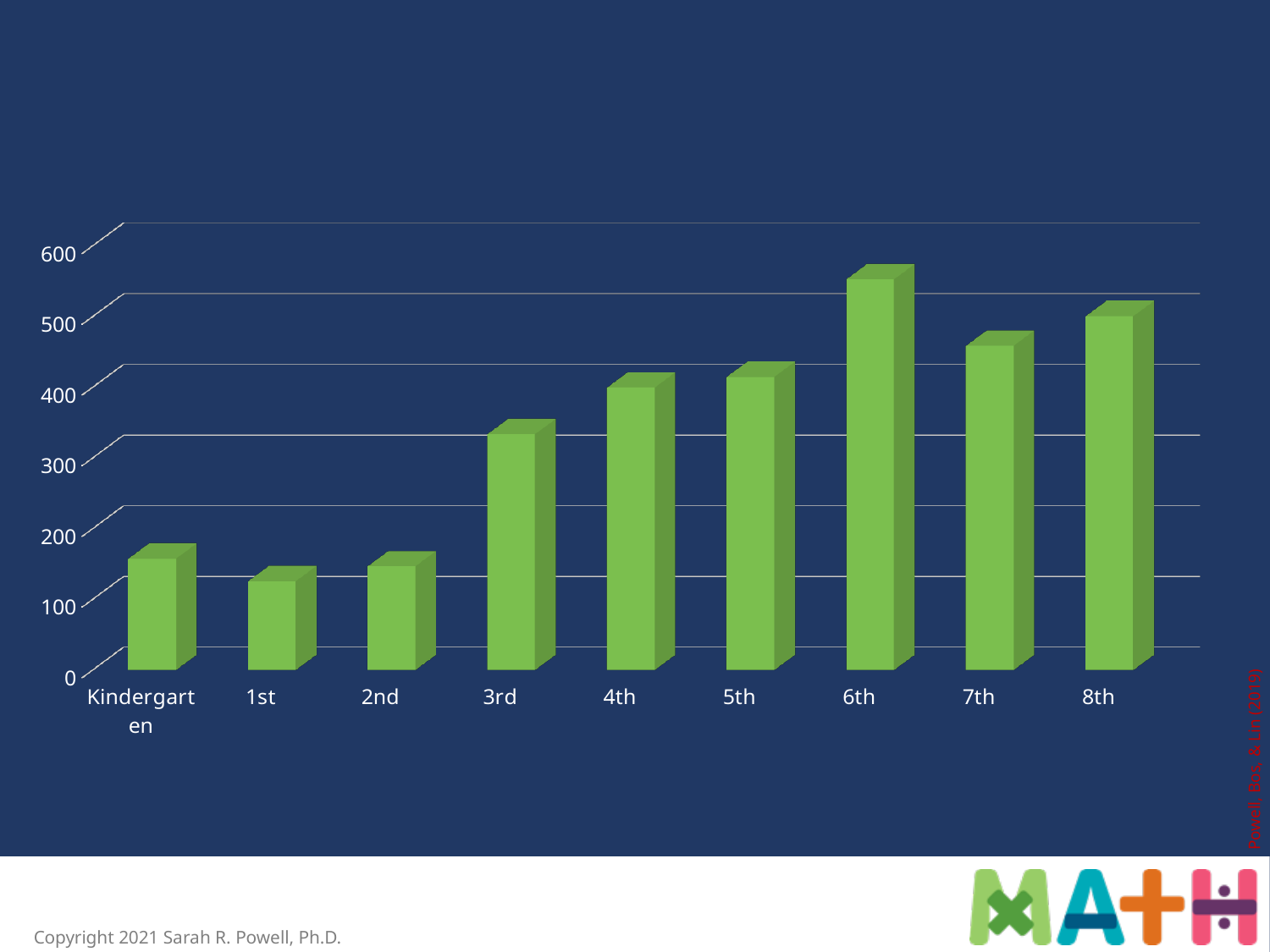
Is the value for 1st greater or less than 200? less Is the value for 3rd greater or less than 300? greater How many grade-level categories are shown on the x axis? 9 Which is larger, the value for 2nd or the value for 3rd? 3rd Is the value for Kindergarten greater or less than 100? greater What is the highest value labelled on the vertical axis? 600 What kind of chart is shown on the slide? bar chart Which grade level has the lowest bar? 1st Which grade level has the highest bar? 6th Which is larger, the value for 8th or the value for 7th? 8th